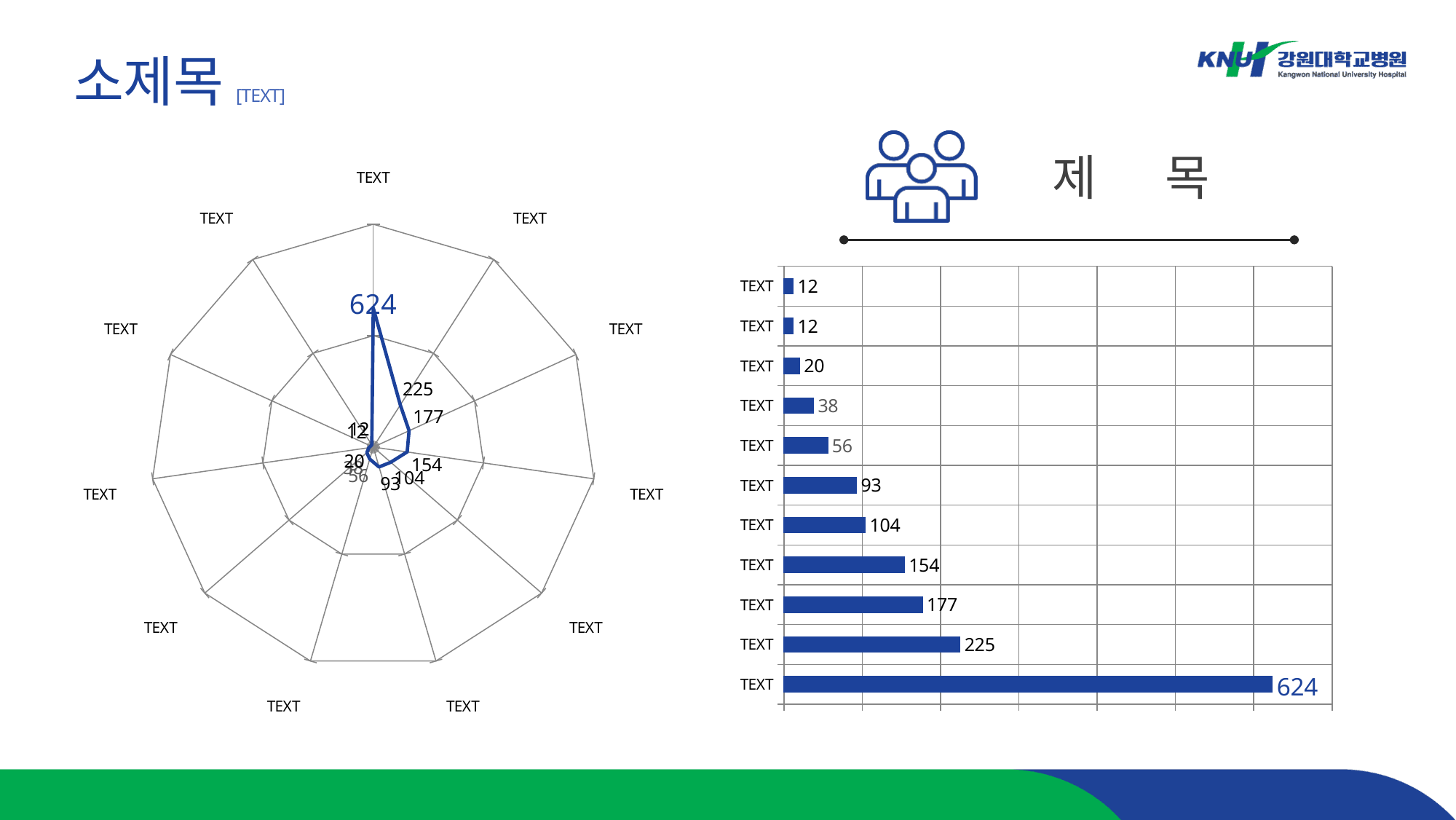
In the bar chart on the right, what is the lowest value shown? 12 In the bar chart on the right, what is the value of the bottom bar? 624 In the bar chart on the right, how many bars are plotted? 11 What kind of chart is the chart on the left side of the slide? radar chart In the bar chart on the right, which is larger: the value of the eighth bar from the top or the seventh bar from the top? 154 In the bar chart on the right, what is the difference between the bars labelled 177 and 154? 23 What kind of chart is the chart on the right side of the slide? bar chart In the bar chart on the right, what is the value of the fourth bar from the top? 38 In the bar chart on the right, what is the highest value shown? 624 In the bar chart on the right, do the values increase or decrease going from the top bar to the bottom bar? increase In the radar chart on the left, what is the largest value labelled? 624 In the bar chart on the right, what is the difference between the largest value (624) and the second largest value (225)? 399